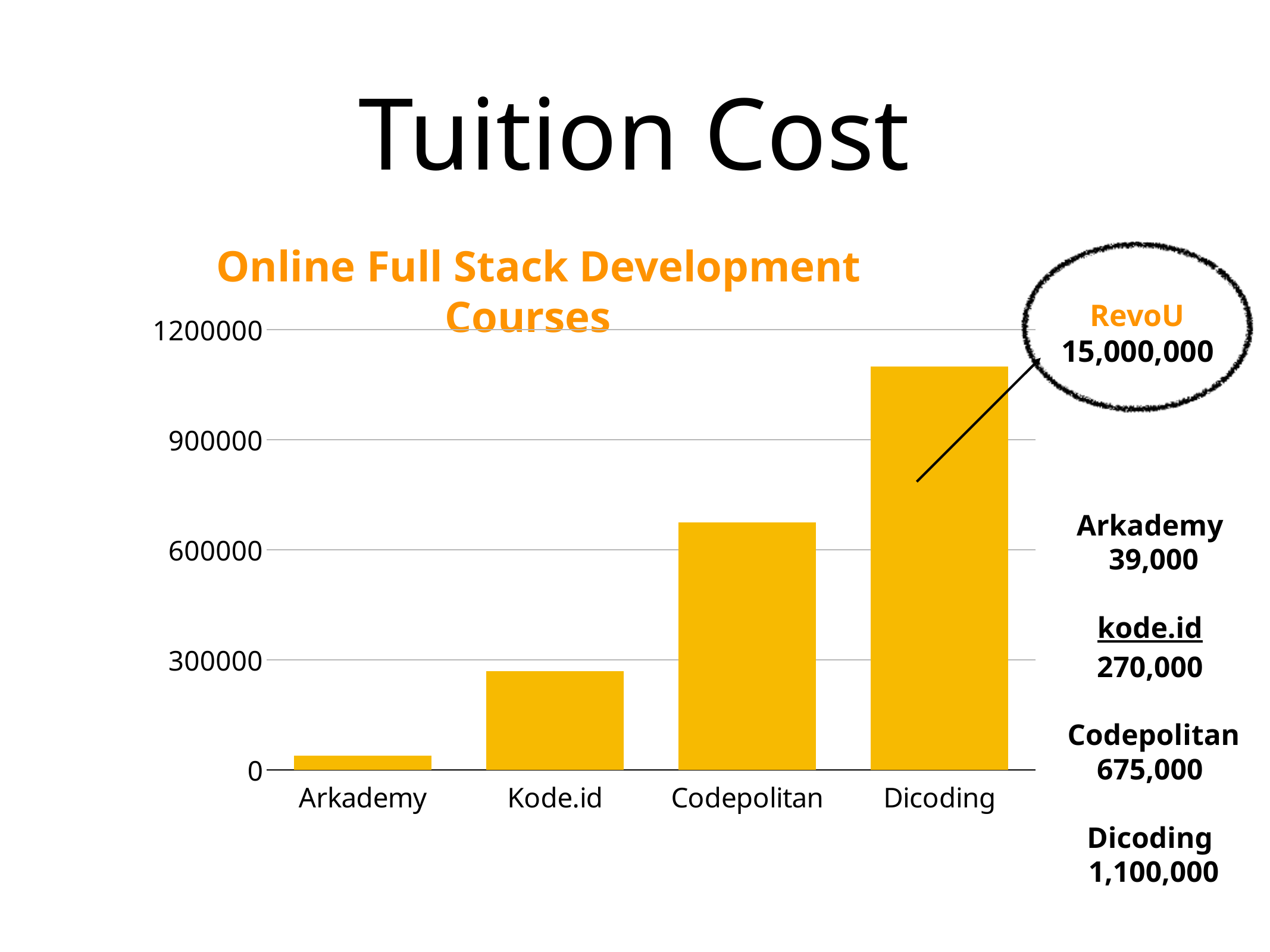
Which has a higher tuition cost, Kode.id or Codepolitan? Codepolitan What is the tuition cost for Arkademy? 39,000 Is the value for Kode.id greater or less than 300000? less Do the values rise or fall from left to right along the x axis? rise How many categories are plotted in the chart? 4 Which category has the lowest tuition cost in the chart? Arkademy What is the title of the chart? Online Full Stack Development Courses What type of chart is shown on the slide? bar chart Which category has the highest tuition cost in the chart? Dicoding What is the tuition cost for Codepolitan? 675,000 What is the difference in tuition cost between Dicoding and Codepolitan? 425,000 What is the tuition cost for Dicoding? 1,100,000